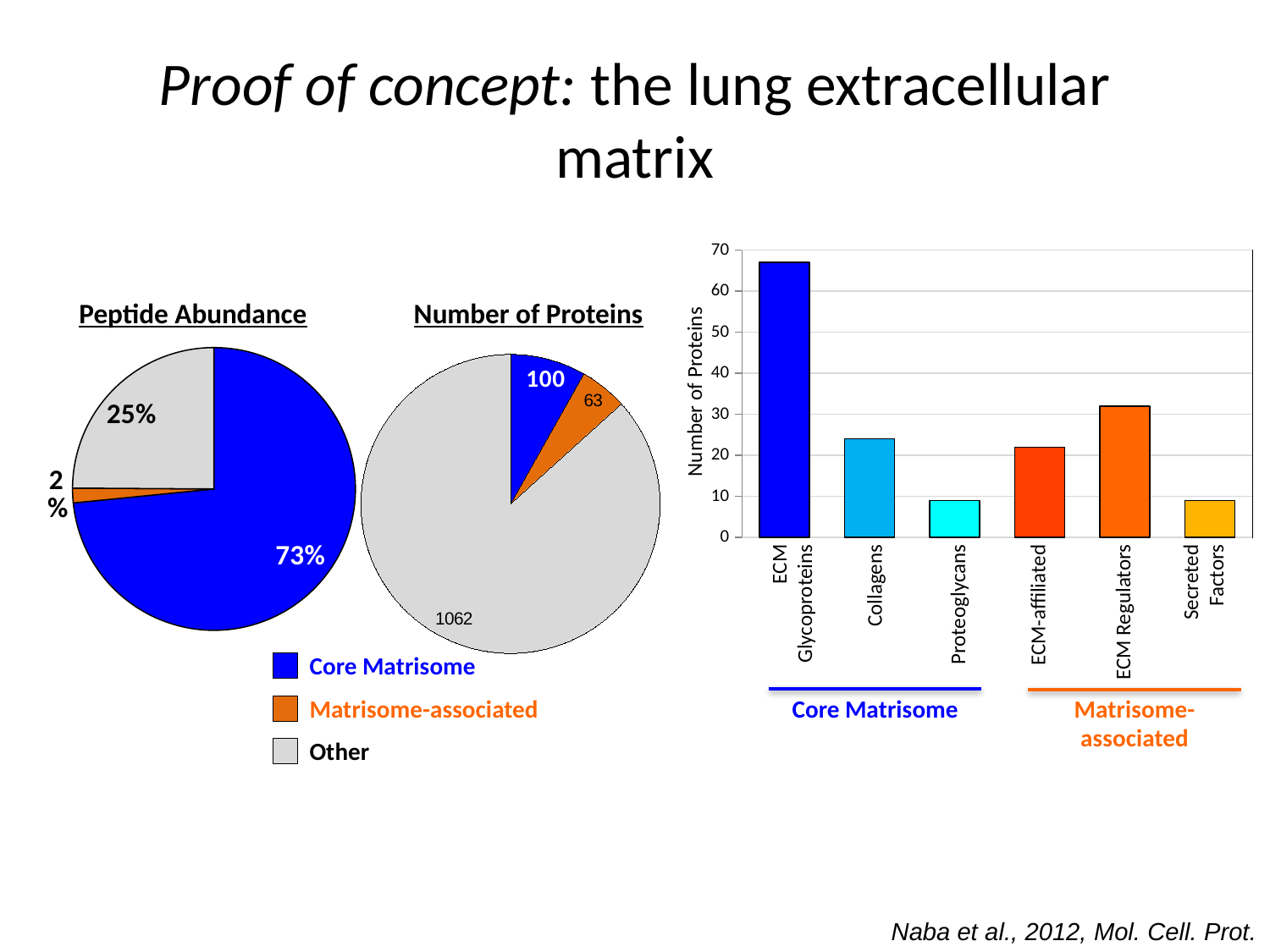
In the Peptide Abundance pie chart, what share is labelled for Other? 25% In the Number of Proteins pie chart, what value is labelled for Other? 1062 In the Peptide Abundance pie chart, what share is labelled for Core Matrisome? 73% In the Number of Proteins pie chart, what is the difference between the Core Matrisome value and the Matrisome-associated value? 37 In the Number of Proteins pie chart, which category has the largest slice? Other In the bar chart on the right, is the value for ECM Regulators greater or less than 30? greater In the bar chart on the right, how many categories are shown on the x axis? 6 In the Number of Proteins pie chart, what value is labelled for Matrisome-associated? 63 In the Peptide Abundance pie chart, which category has the smallest slice? Matrisome-associated In the bar chart on the right, which category has the highest bar? ECM Glycoproteins In the bar chart on the right, is the value for Proteoglycans greater or less than 10? less In the bar chart on the right, which is larger, Collagens or ECM Regulators? ECM Regulators